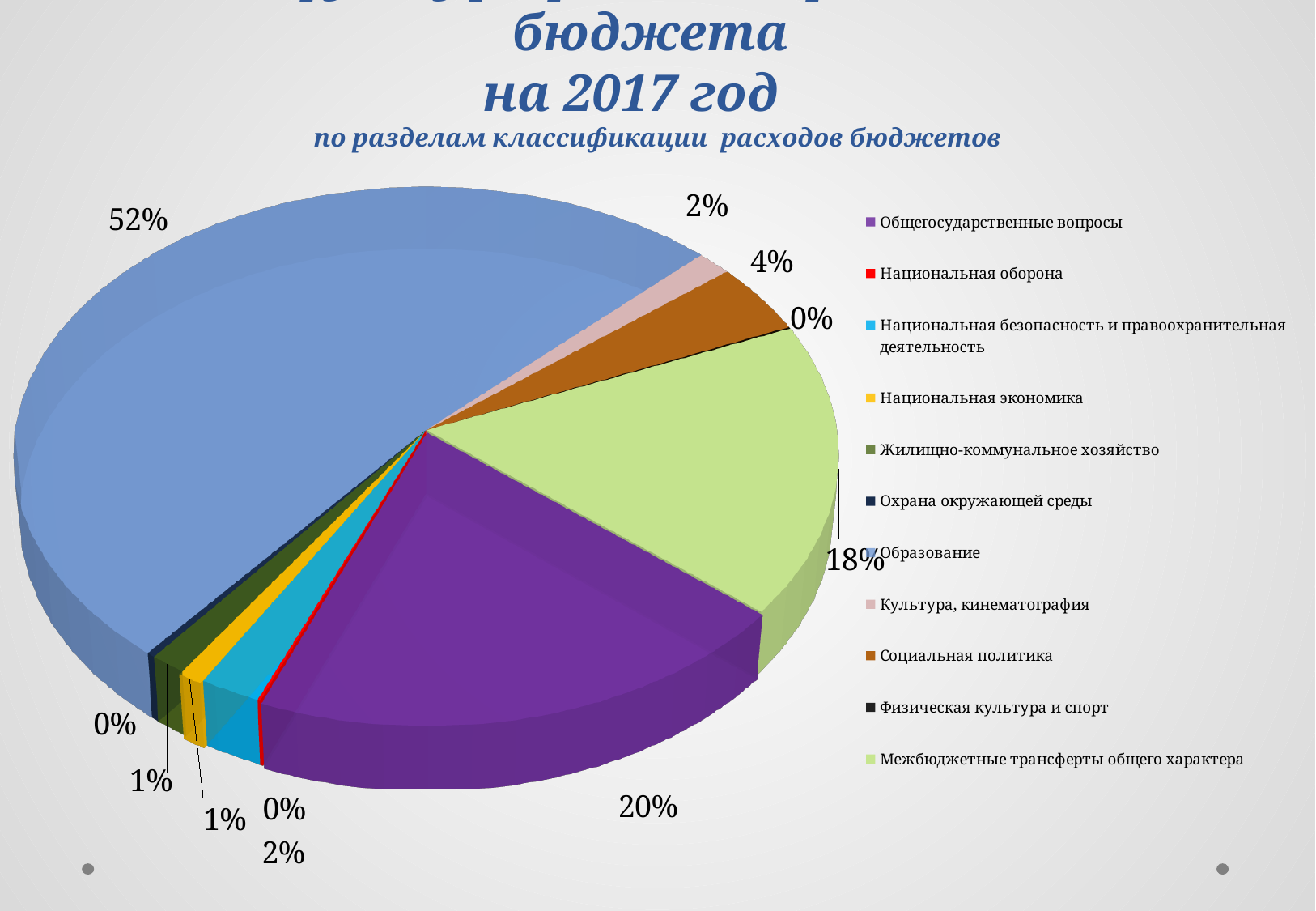
What share of the pie does Общегосударственные вопросы account for? 20% What is the difference in percentage points between the Образование slice and the Общегосударственные вопросы slice? 32 What share of the pie does Национальная экономика account for? 1% What share of the pie does Образование account for? 52% What share of the pie does Социальная политика account for? 4% What share of the pie does Межбюджетные трансферты общего характера account for? 18% How many categories does the legend list? 11 Which slice is larger: Общегосударственные вопросы or Межбюджетные трансферты общего характера? Общегосударственные вопросы What kind of chart is shown on the slide? Pie chart What colour is the Образование slice in the legend? Light blue Which category has the largest slice of the pie? Образование What share of the pie does Культура, кинематография account for? 2%